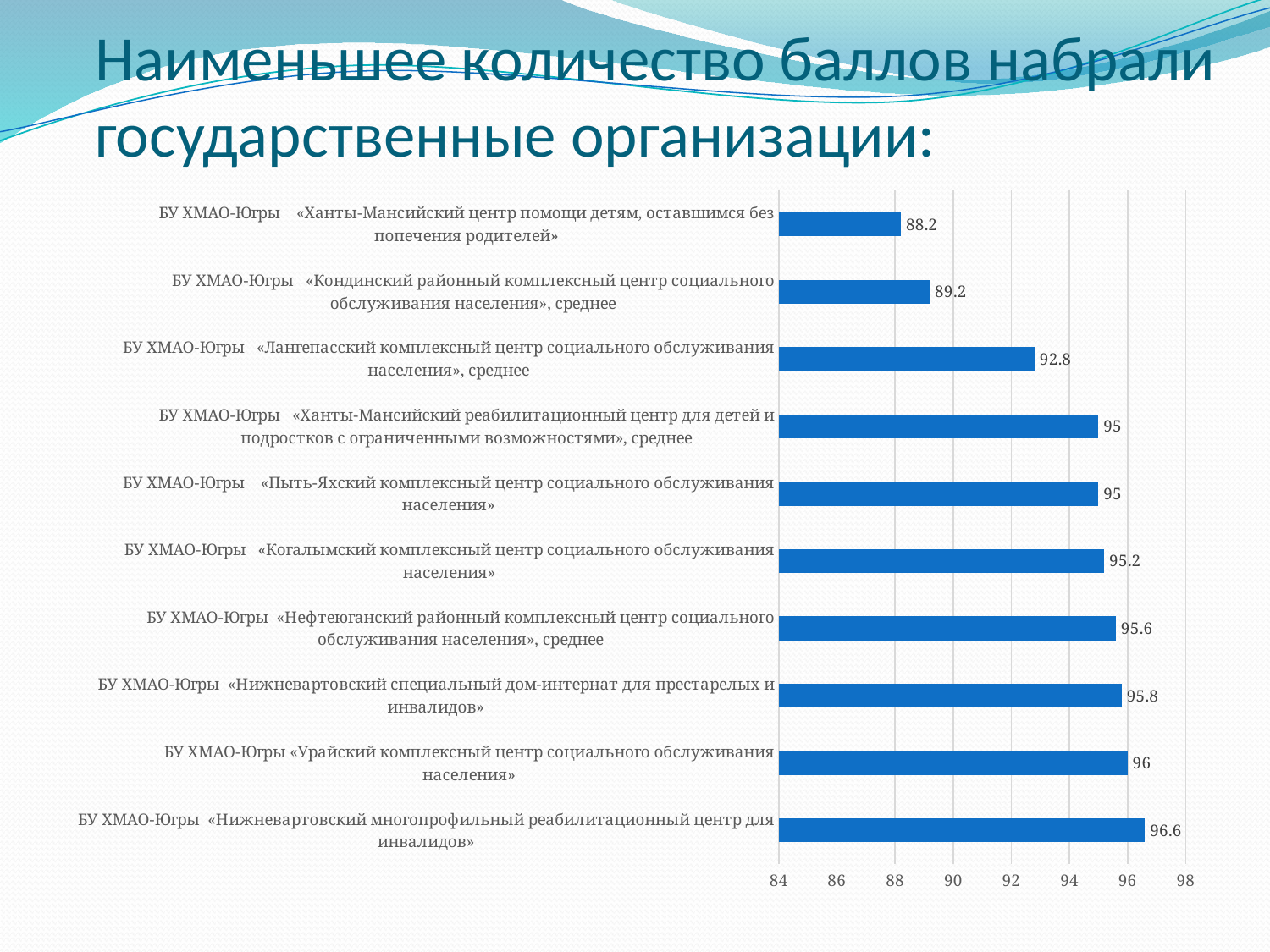
What is the value for БУ ХМАО-Югры «Нижневартовский специальный дом-интернат для престарелых и инвалидов»? 95.8 How many organizations are plotted in the chart? 10 What is the value for БУ ХМАО-Югры «Ханты-Мансийский центр помощи детям, оставшимся без попечения родителей»? 88.2 Which is larger: the value for БУ ХМАО-Югры «Нефтеюганский районный комплексный центр социального обслуживания населения», среднее or the value for БУ ХМАО-Югры «Лангепасский комплексный центр социального обслуживания населения», среднее? БУ ХМАО-Югры «Нефтеюганский районный комплексный центр социального обслуживания населения», среднее What is the value for БУ ХМАО-Югры «Урайский комплексный центр социального обслуживания населения»? 96 What type of chart is shown on the slide? bar chart What is the difference between the value for БУ ХМАО-Югры «Нижневартовский многопрофильный реабилитационный центр для инвалидов» and the value for БУ ХМАО-Югры «Ханты-Мансийский центр помощи детям, оставшимся без попечения родителей»? 8.4 Is the value for БУ ХМАО-Югры «Когалымский комплексный центр социального обслуживания населения» greater or less than 94? greater Which organization has the highest value in the chart? БУ ХМАО-Югры «Нижневартовский многопрофильный реабилитационный центр для инвалидов» Which organization has the lowest value in the chart? БУ ХМАО-Югры «Ханты-Мансийский центр помощи детям, оставшимся без попечения родителей» What is the value for БУ ХМАО-Югры «Лангепасский комплексный центр социального обслуживания населения», среднее? 92.8 What is the value for БУ ХМАО-Югры «Кондинский районный комплексный центр социального обслуживания населения», среднее? 89.2